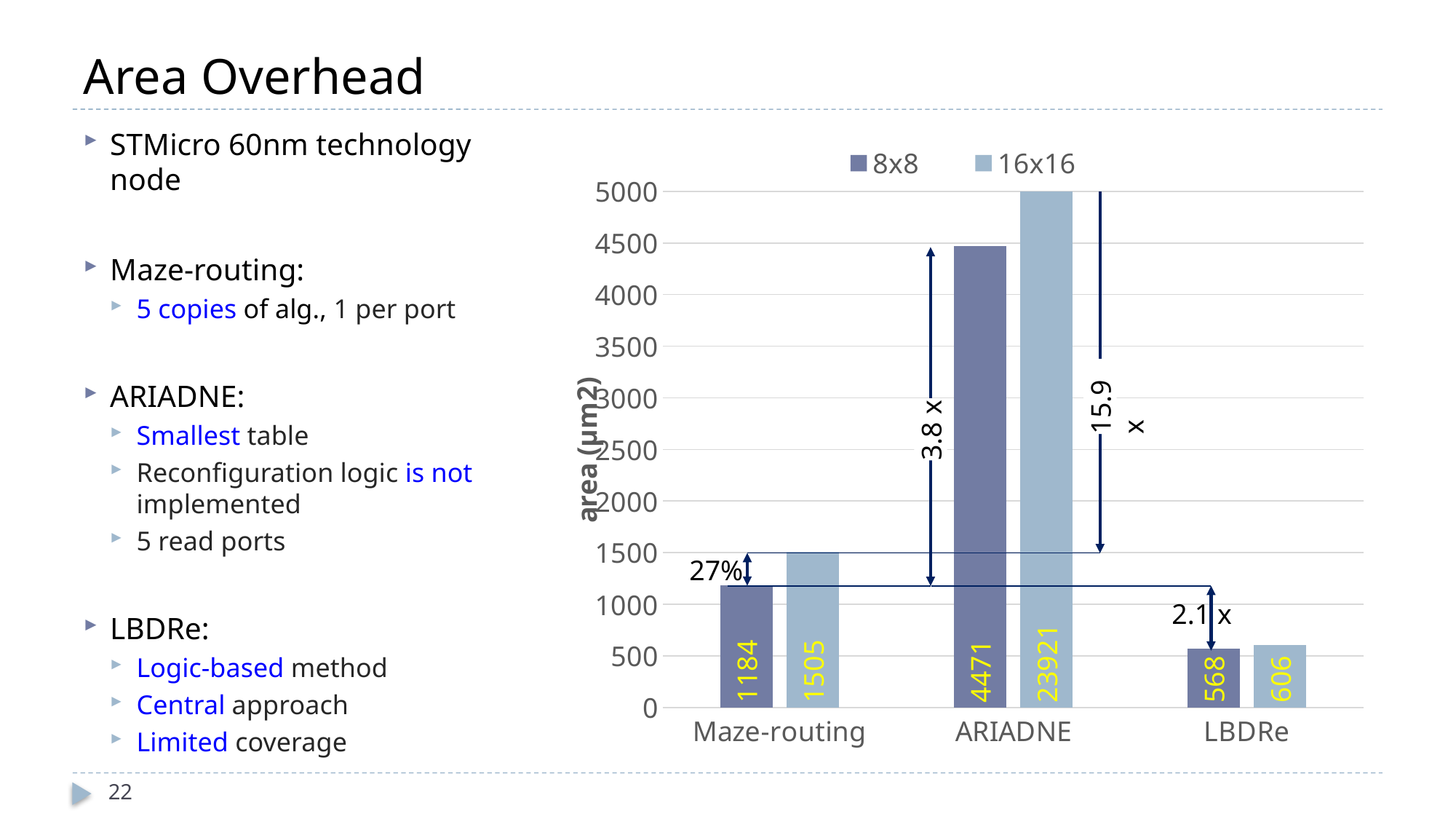
How many series does the legend list? 2 What is the label of the y axis? area (µm2) What is the difference between the 16x16 and 8x8 area values for Maze-routing? 321 What kind of chart is shown on the slide? Bar chart How many categories are shown on the x axis? 3 Which category has the highest 8x8 area value? ARIADNE Which category has the lowest 16x16 area value? LBDRe What is the 16x16 area value for ARIADNE? 23921 What is the 8x8 area value for LBDRe? 568 What is the 16x16 area value for Maze-routing? 1505 What is the 8x8 area value for Maze-routing? 1184 Which is larger, the 8x8 area value for ARIADNE or the 8x8 area value for Maze-routing? ARIADNE